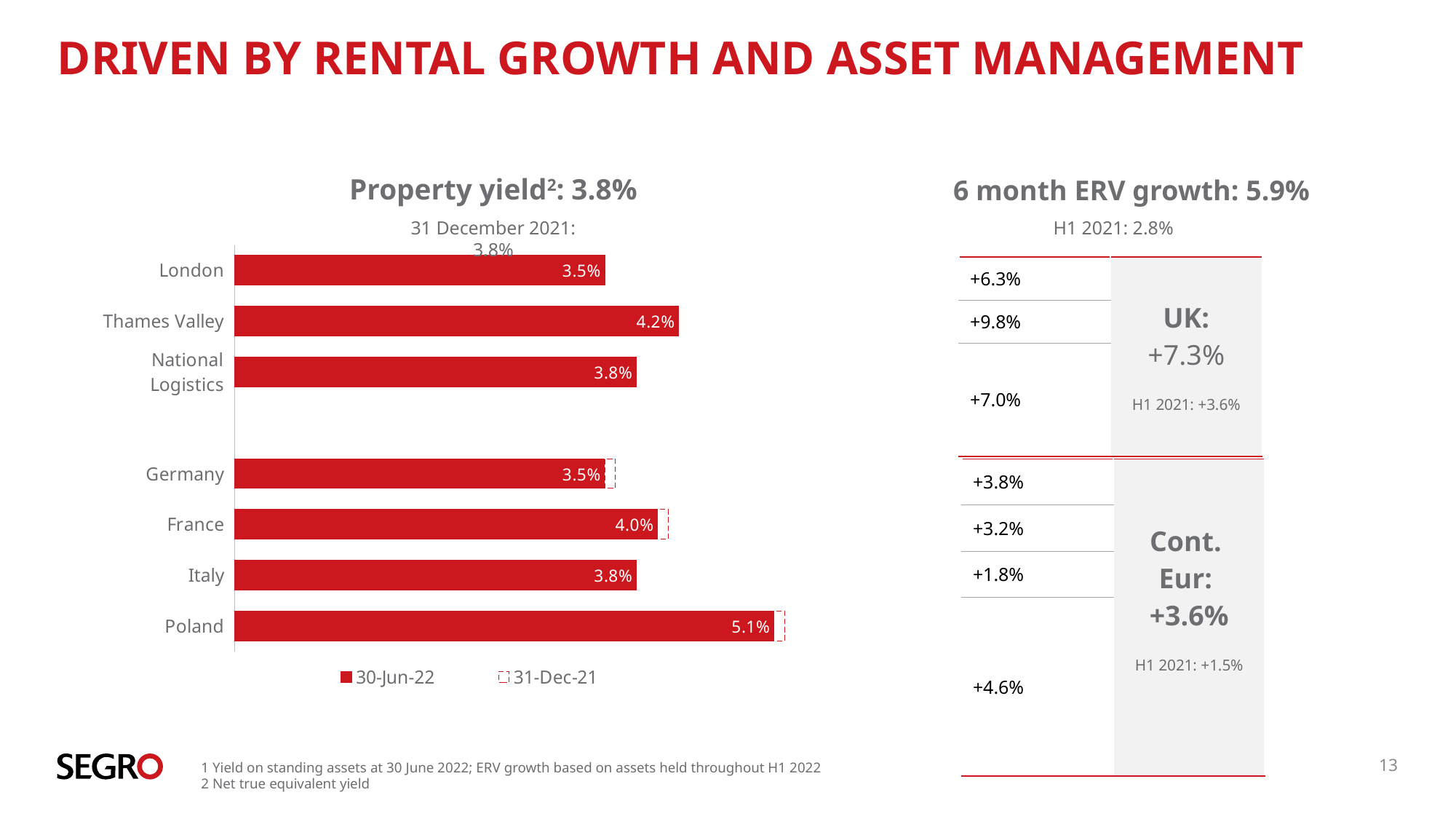
Which has a higher 30-Jun-22 property yield, France or Italy? France Which category has the highest 30-Jun-22 property yield? Poland What kind of chart is the property yield chart? Bar chart How many series does the legend of the property yield chart list? 2 What is the difference between the 30-Jun-22 property yields of Poland and London? 1.6% What is the 30-Jun-22 property yield for Thames Valley? 4.2% What is the 30-Jun-22 property yield for France? 4.0% What is the 30-Jun-22 property yield for Poland? 5.1% How many categories are shown in the property yield chart? 7 What is the 30-Jun-22 property yield for National Logistics? 3.8% What are the two series named in the legend of the property yield chart? 30-Jun-22 and 31-Dec-21 What is the difference between the 30-Jun-22 property yields of Thames Valley and Germany? 0.7%